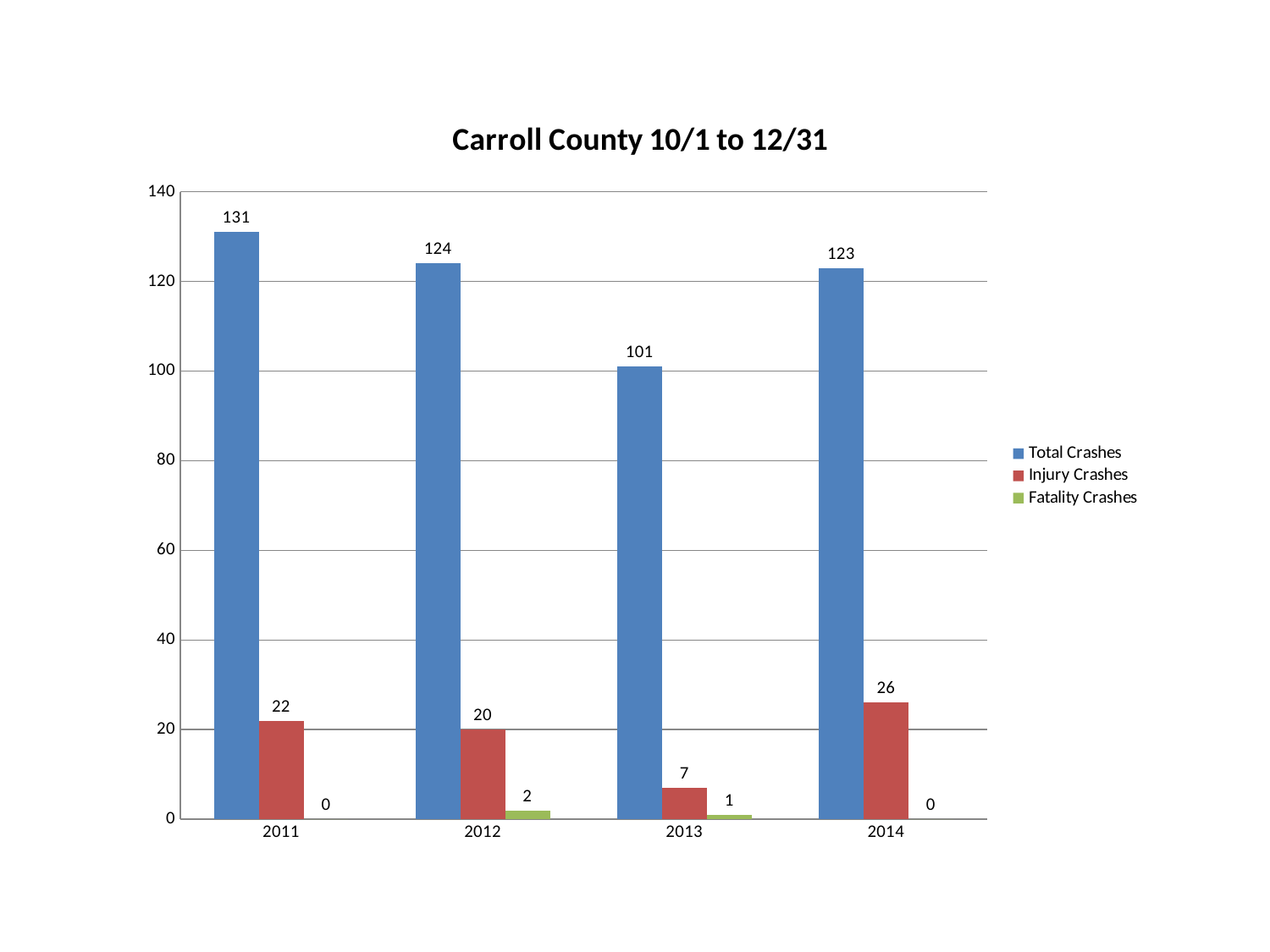
How many years are shown on the x axis? 4 What is the value for Fatality Crashes in 2012? 2 What kind of chart is shown on the slide? bar chart Is the value for Total Crashes in 2013 greater or less than 120? less What is the value for Total Crashes in 2011? 131 What is the value for Injury Crashes in 2014? 26 What is the title of the chart? Carroll County 10/1 to 12/31 How many series does the legend list? 3 What is the difference between Total Crashes in 2011 and Total Crashes in 2013? 30 Which year has the highest value for Total Crashes? 2011 Which year has the lowest value for Injury Crashes? 2013 Which is larger, Injury Crashes in 2011 or Injury Crashes in 2012? Injury Crashes in 2011